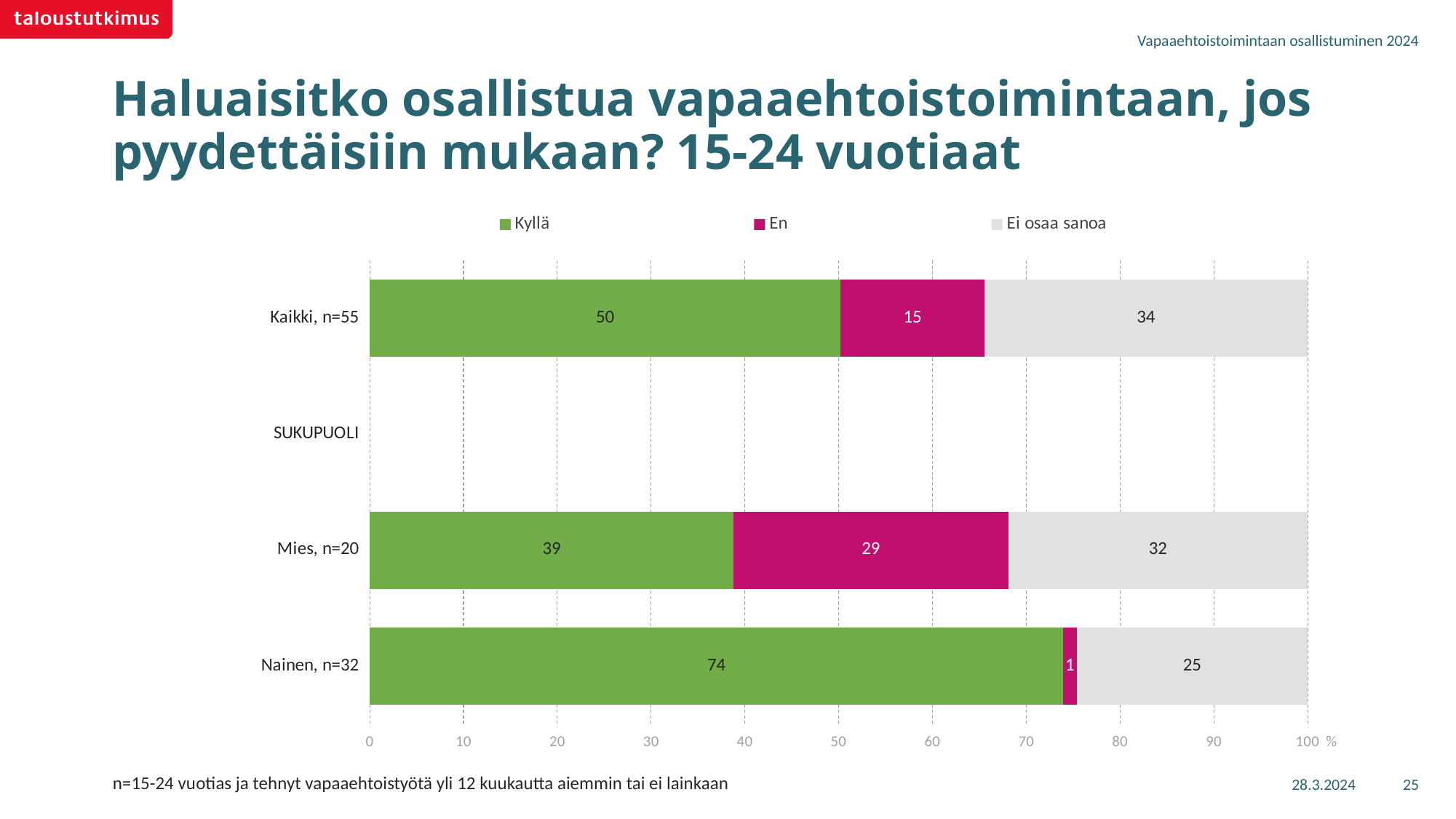
What is the difference between the Kyllä values for Nainen, n=32 and Mies, n=20? 35 Which category has the highest Kyllä value? Nainen, n=32 What is the En value for Mies, n=20? 29 How many series does the legend list? 3 Which is larger, the Ei osaa sanoa value for Kaikki, n=55 or for Mies, n=20? Kaikki, n=55 What is the Kyllä value for Kaikki, n=55? 50 What kind of chart is shown on the slide? Stacked bar chart How many categories have bars plotted in the chart? 3 Which category has the lowest En value? Nainen, n=32 What is the Ei osaa sanoa value for Nainen, n=32? 25 Which colour represents the En series in the chart? Magenta What is the total of the stacked bar for Mies, n=20? 100